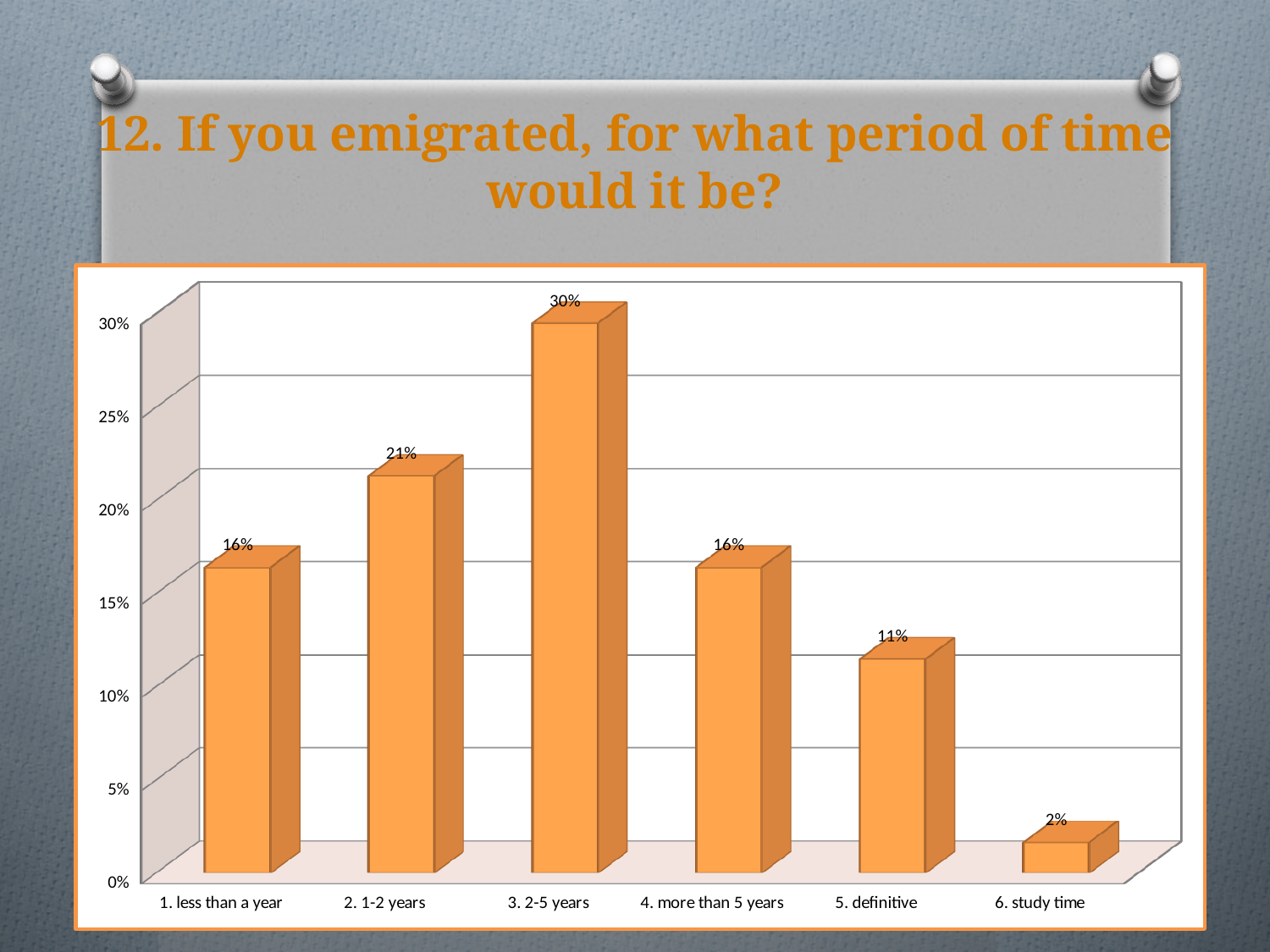
What is the title of the slide above the chart? 12. If you emigrated, for what period of time would it be? How many categories are shown on the x axis? 6 What is the difference between the values for "3. 2-5 years" and "2. 1-2 years"? 9% Is the value for "4. more than 5 years" greater or less than 20%? less Which category has the highest value? 3. 2-5 years What is the value for "6. study time"? 2% What is the value for "5. definitive"? 11% What is the value for "2. 1-2 years"? 21% What kind of chart is shown on the slide? bar chart Which category has the lowest value? 6. study time Which is larger, the value for "2. 1-2 years" or the value for "5. definitive"? 2. 1-2 years What is the value for "3. 2-5 years"? 30%